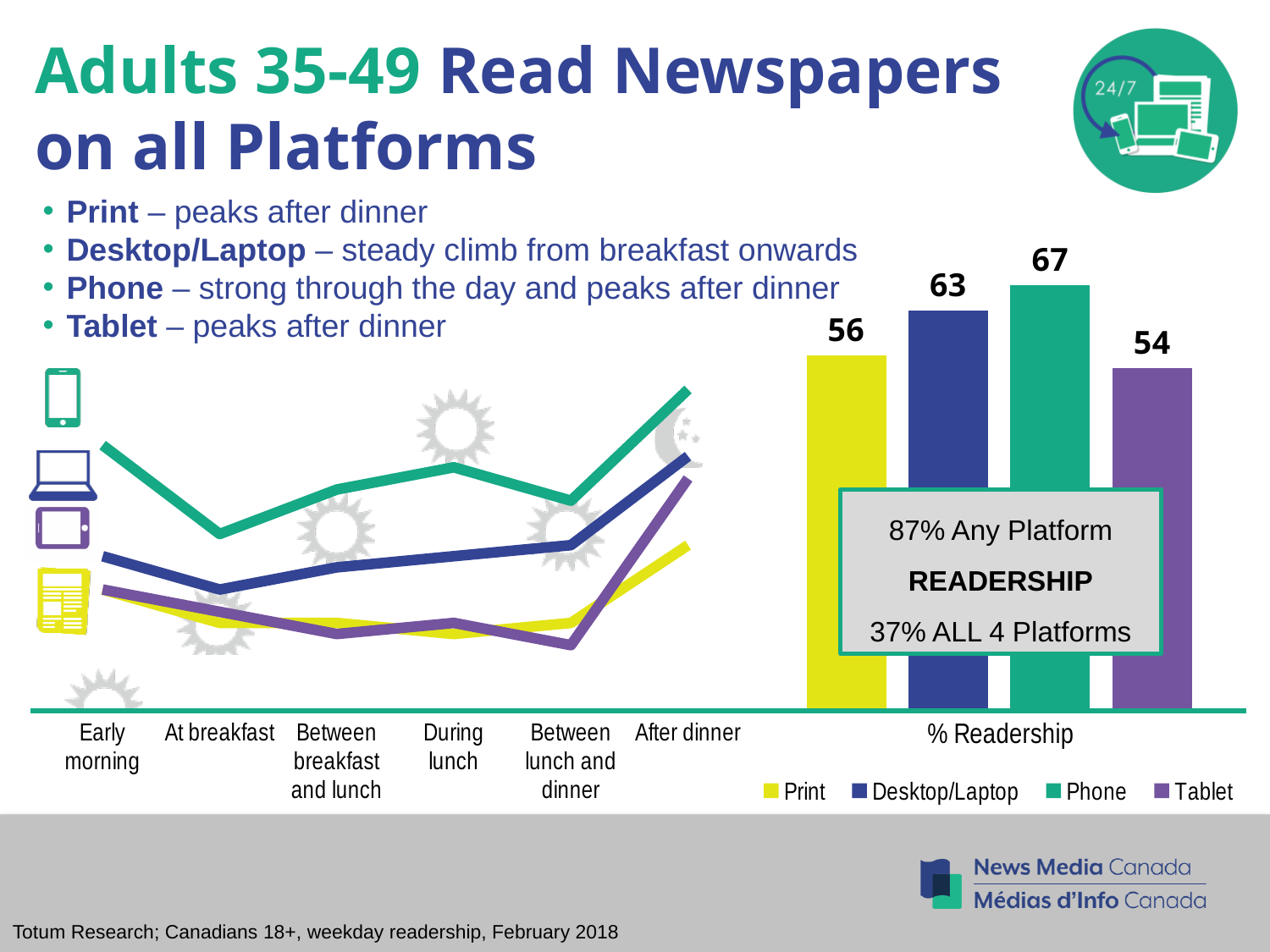
In the line chart on the left, which series is highest at After dinner? Phone In the % Readership bar chart, how many platforms are shown? 4 What kind of chart is the chart on the right of the slide? Bar chart In the % Readership bar chart, which platform has the lowest readership? Tablet How many series does the legend list? 4 In the % Readership bar chart, which is larger, Desktop/Laptop or Print? Desktop/Laptop In the % Readership bar chart, what is the value for Phone? 67 In the % Readership bar chart, what is the value for Print? 56 In the line chart on the left, how many time-of-day categories are on the x axis? 6 In the line chart on the left, does the Print line rise or fall from Between lunch and dinner to After dinner? Rise In the % Readership bar chart, which platform has the highest readership? Phone In the % Readership bar chart, what is the difference between the Phone and Tablet values? 13